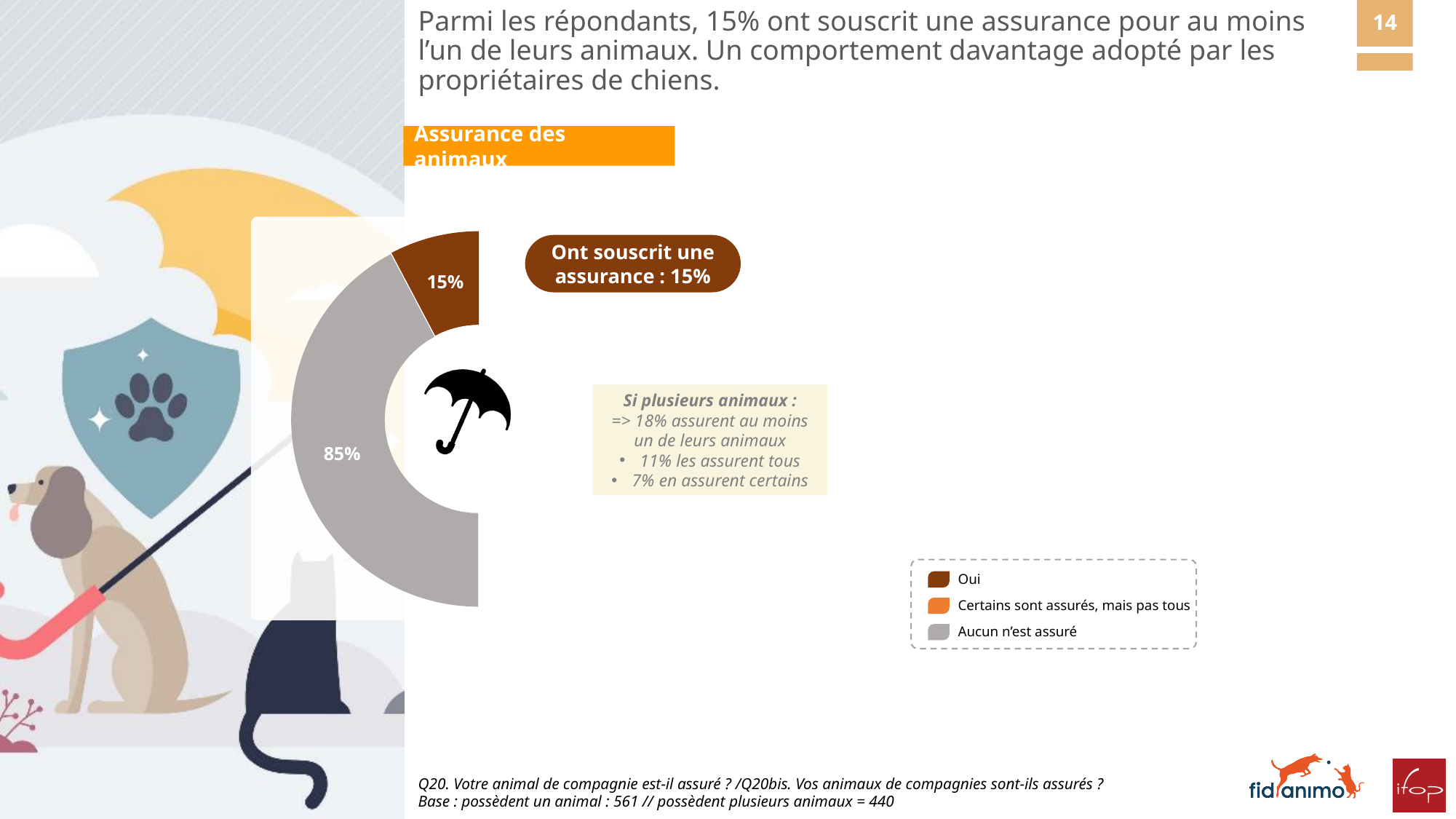
Which category has the smallest share among the labelled slices? Oui What percentage of respondents answered "Oui" (have insured their animal)? 15% How many entries does the legend list? 3 What is the total of the two labelled slices, 15% and 85%? 100% What is the title shown in the orange box above the chart? Assurance des animaux What percentage corresponds to "Aucun n'est assuré"? 85% Which category has the largest share of the pie? Aucun n'est assuré How many slices have a data label printed on the chart? 2 What colour is the "Oui" slice? brown What kind of chart is shown on the slide? doughnut chart What is the difference between the "Aucun n'est assuré" share and the "Oui" share? 70 points Which is larger, the "Oui" slice or the "Aucun n'est assuré" slice? Aucun n'est assuré